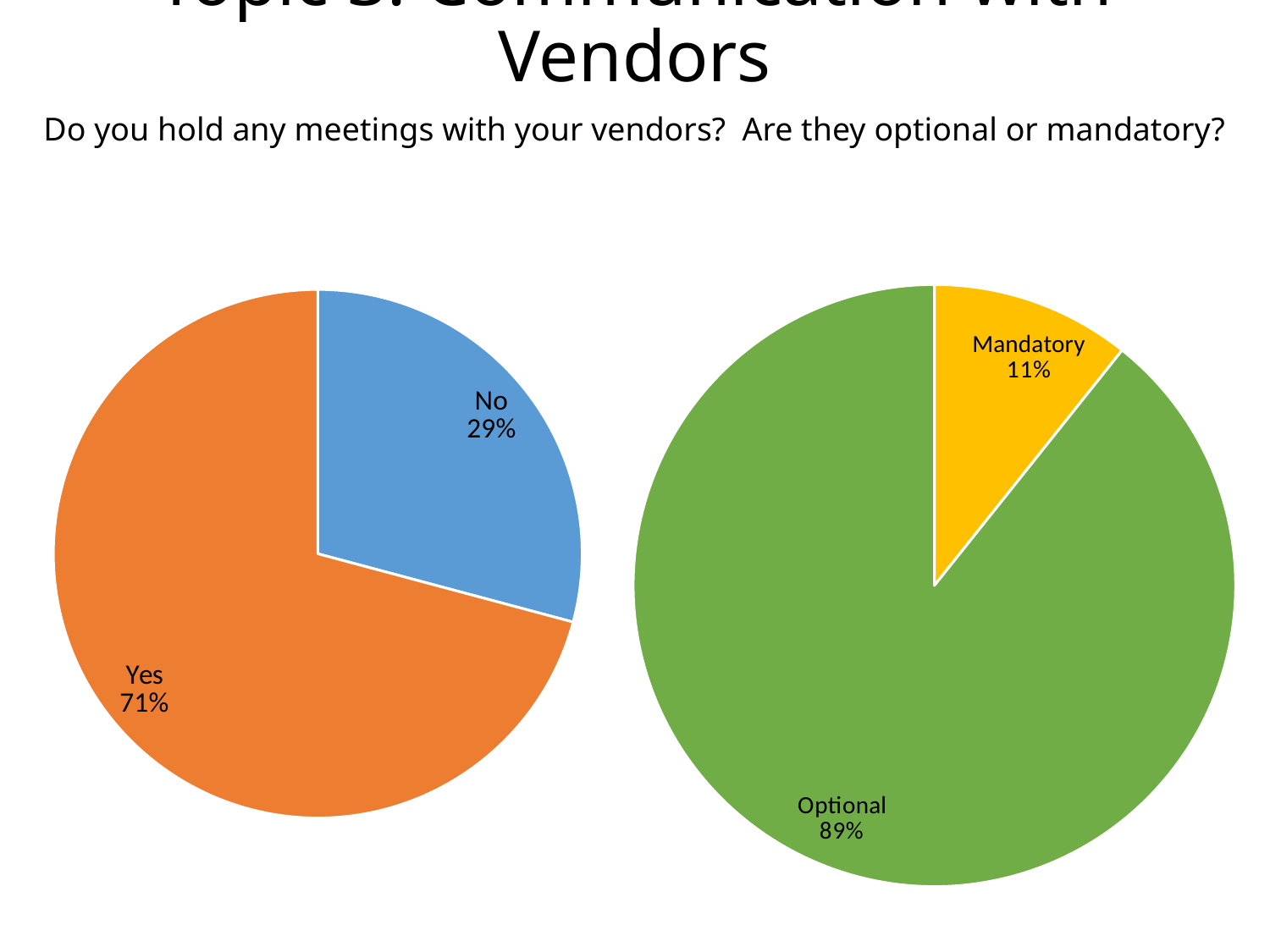
In the left pie chart, which slice is the largest? Yes In the right pie chart, which is larger, Optional or Mandatory? Optional In the right pie chart, which slice is the smallest? Mandatory What type of chart is the right chart on the slide? Pie chart In the left pie chart, what share of respondents answered Yes? 71% In the right pie chart, what share of meetings are Optional? 89% How many slices does the left pie chart have? 2 In the left pie chart, what is the difference in percentage points between Yes and No? 42 In the right pie chart, what share of meetings are Mandatory? 11% In the left pie chart, what share of respondents answered No? 29% In the left pie chart, what colour is the Yes slice? Orange In the right pie chart, what is the difference in percentage points between Optional and Mandatory? 78